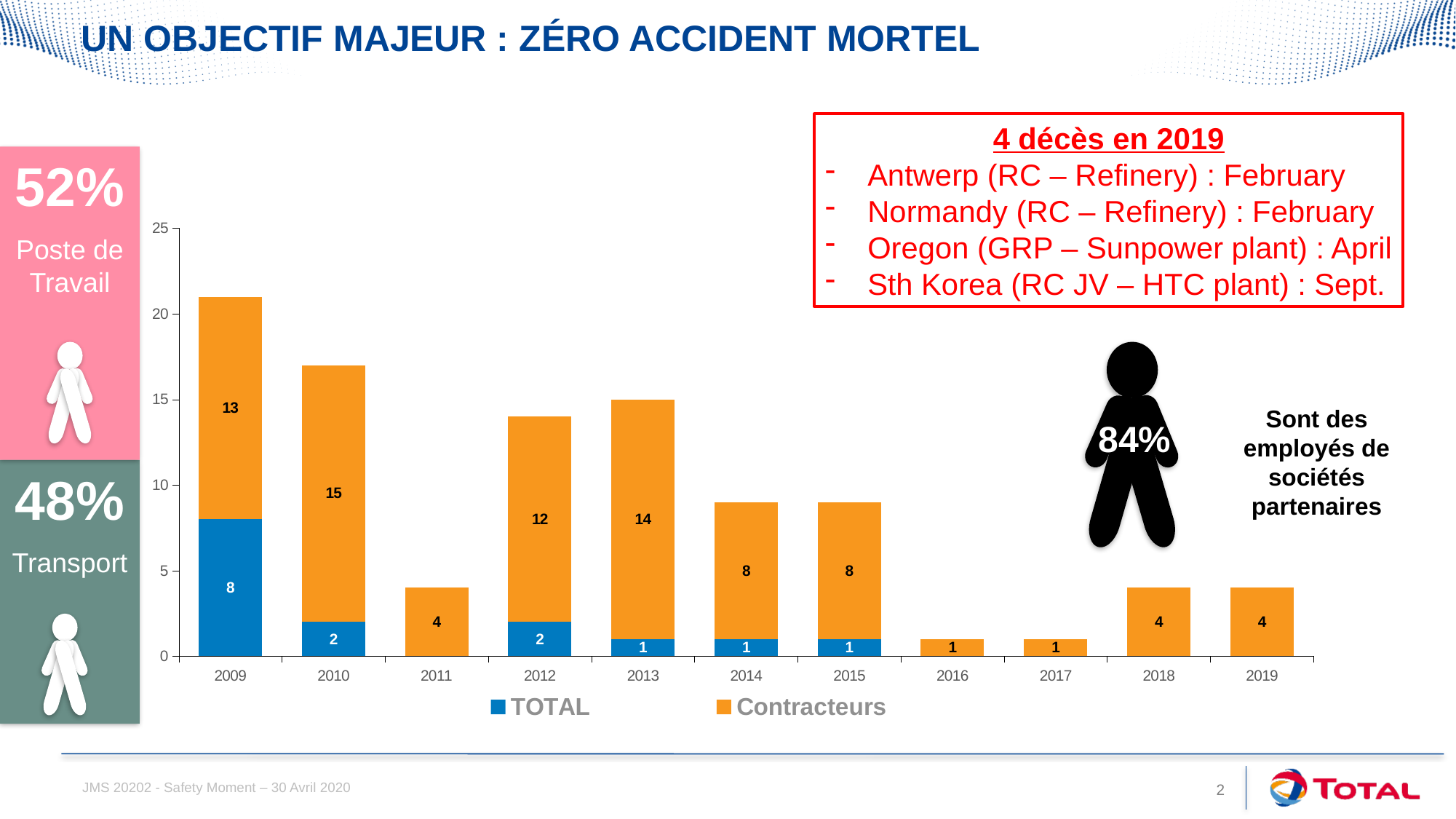
What is the TOTAL (blue) value for 2009? 8 What is the difference between the Contracteurs values for 2013 and 2014? 6 What is the combined height of the stacked bar for 2009 (TOTAL plus Contracteurs)? 21 What kind of chart is shown on the slide? Stacked bar chart What is the Contracteurs value for 2010? 15 What is the combined height of the stacked bar for 2013 (TOTAL plus Contracteurs)? 15 Which is larger, the Contracteurs value for 2012 or for 2015? 2012 How many years are shown on the x axis of the chart? 11 How many series does the chart legend list? 2 What is the Contracteurs value for 2019? 4 What are the two series named in the chart legend? TOTAL and Contracteurs Which year has the highest Contracteurs value? 2010